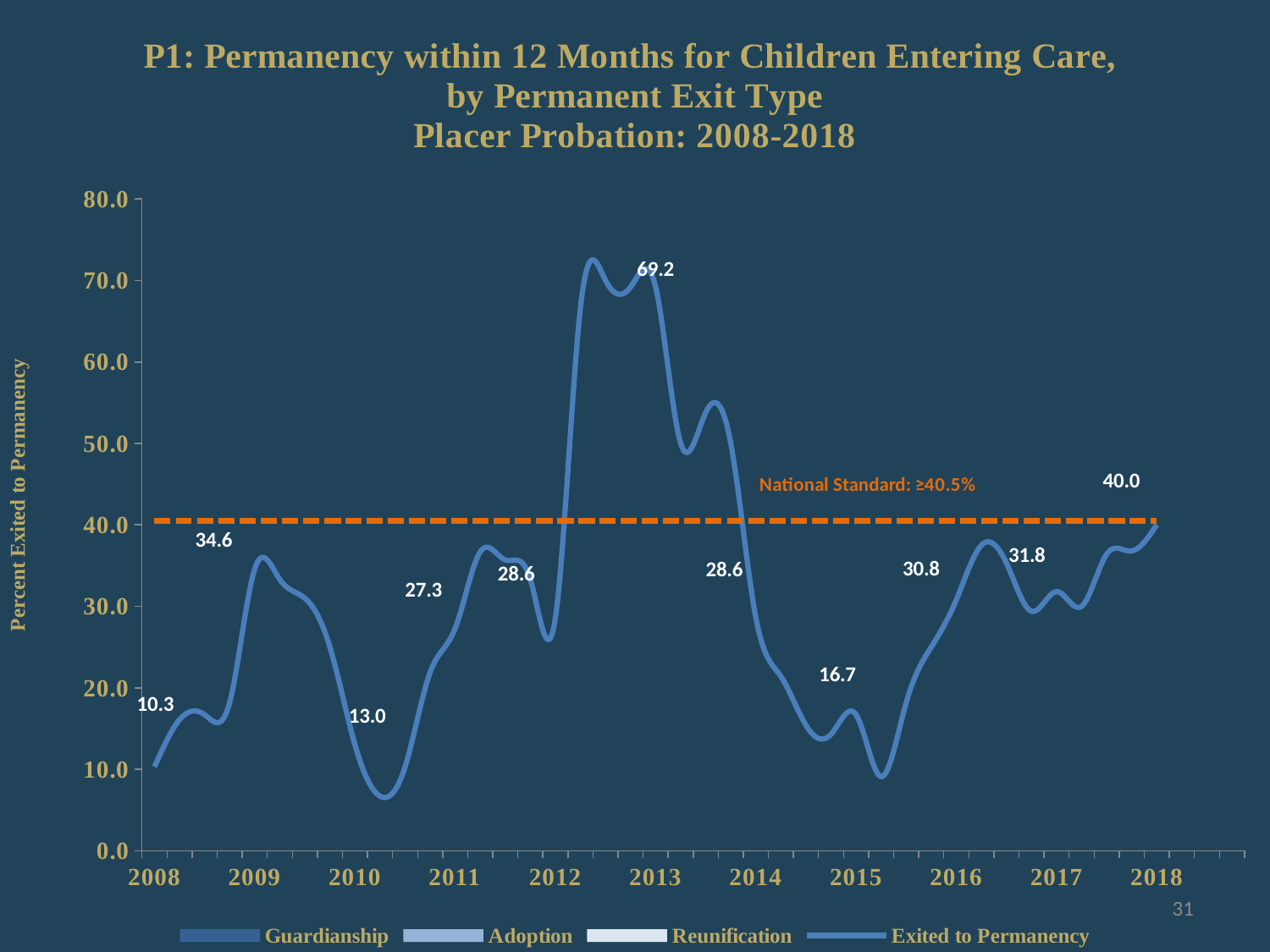
How many years are labelled on the x axis? 11 Which is larger, the value for 2009 or the value for 2010? 2009 Is the value for 2013 greater or less than 60.0? greater What is the value for 2013? 69.2 What is the value for 2015? 16.7 How many series does the legend list? 4 What is the difference between the 2018 value and the 2008 value? 29.7 What is the value for 2018? 40.0 What kind of chart is this? line chart Which year has the lowest labelled value? 2008 What is the National Standard shown on the chart? ≥40.5%